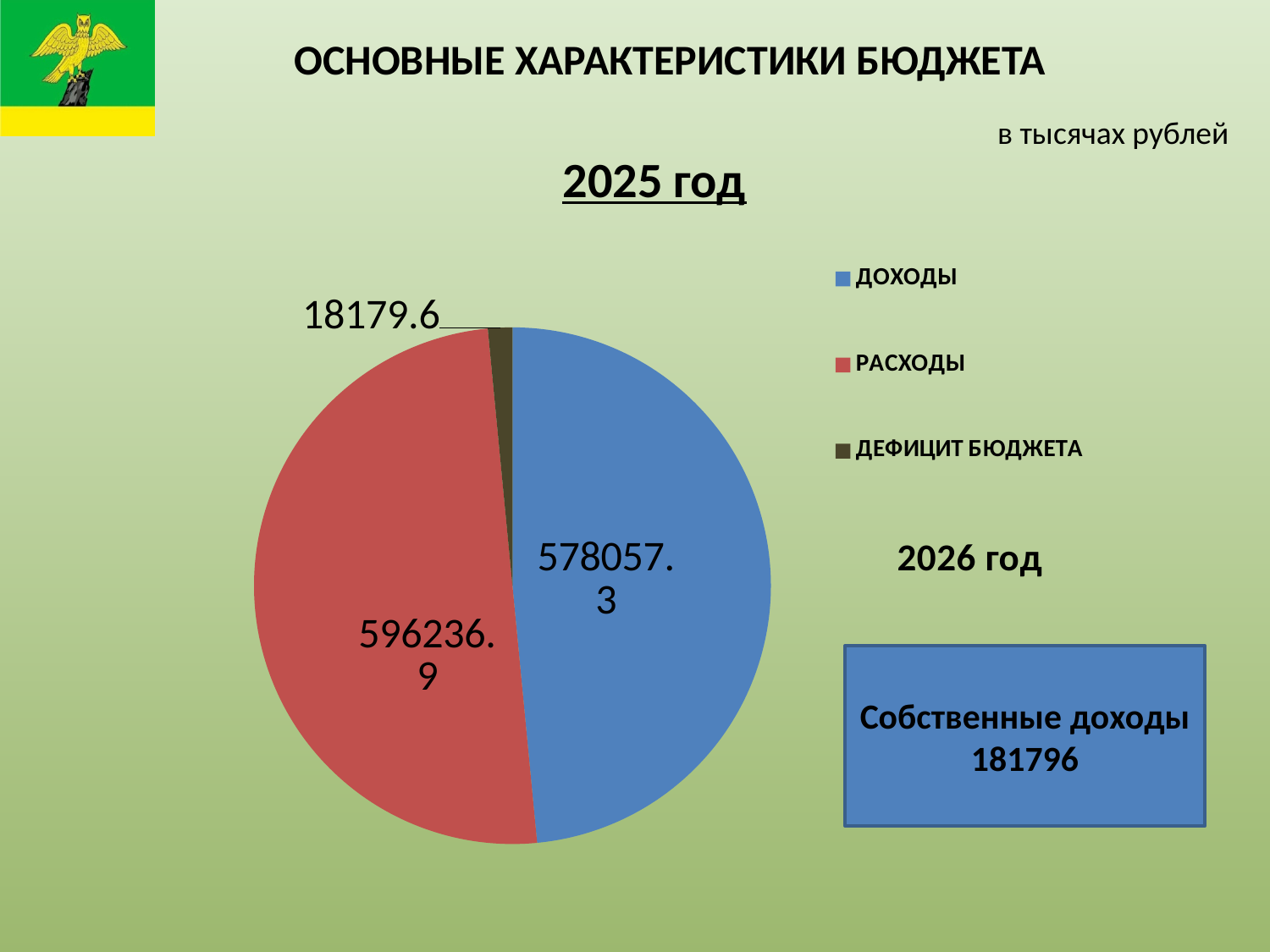
Which category has the smallest slice in the pie chart? ДЕФИЦИТ БЮДЖЕТА What is the difference between РАСХОДЫ and ДОХОДЫ? 18179.6 What is the value for ДЕФИЦИТ БЮДЖЕТА in the pie chart? 18179.6 How many entries does the legend list? 3 How many slices does the pie chart have? 3 What colour is the ДОХОДЫ slice in the pie chart? blue Which category has the largest slice in the pie chart? РАСХОДЫ What type of chart is shown on the slide? pie chart Which is larger, РАСХОДЫ or ДОХОДЫ? РАСХОДЫ What is the value for РАСХОДЫ in the pie chart? 596236.9 What is the value for ДОХОДЫ in the pie chart? 578057.3 What year is shown as the title above the pie chart? 2025 год